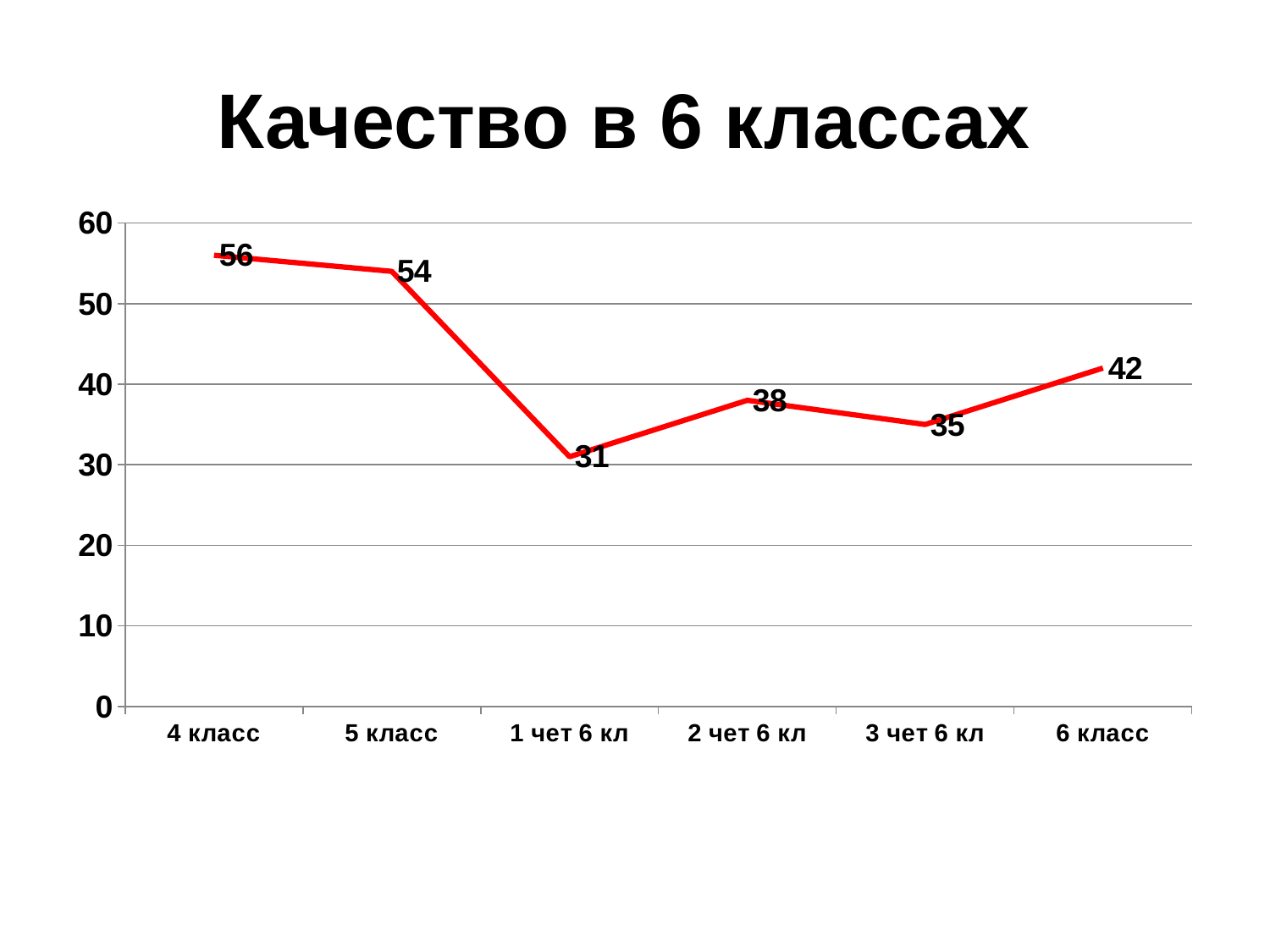
What is the value for 6 класс? 42 How many categories are shown on the x axis? 6 Is the value for 5 класс greater or less than 50? greater What is the title of the chart? Качество в 6 классах Which is larger, the value for 2 чет 6 кл or the value for 3 чет 6 кл? 2 чет 6 кл What is the difference between the values for 6 класс and 3 чет 6 кл? 7 Which category has the highest value? 4 класс Which category has the lowest value? 1 чет 6 кл What is the difference between the values for 4 класс and 1 чет 6 кл? 25 What is the value for 1 чет 6 кл? 31 What is the value for 4 класс? 56 What kind of chart is this? line chart